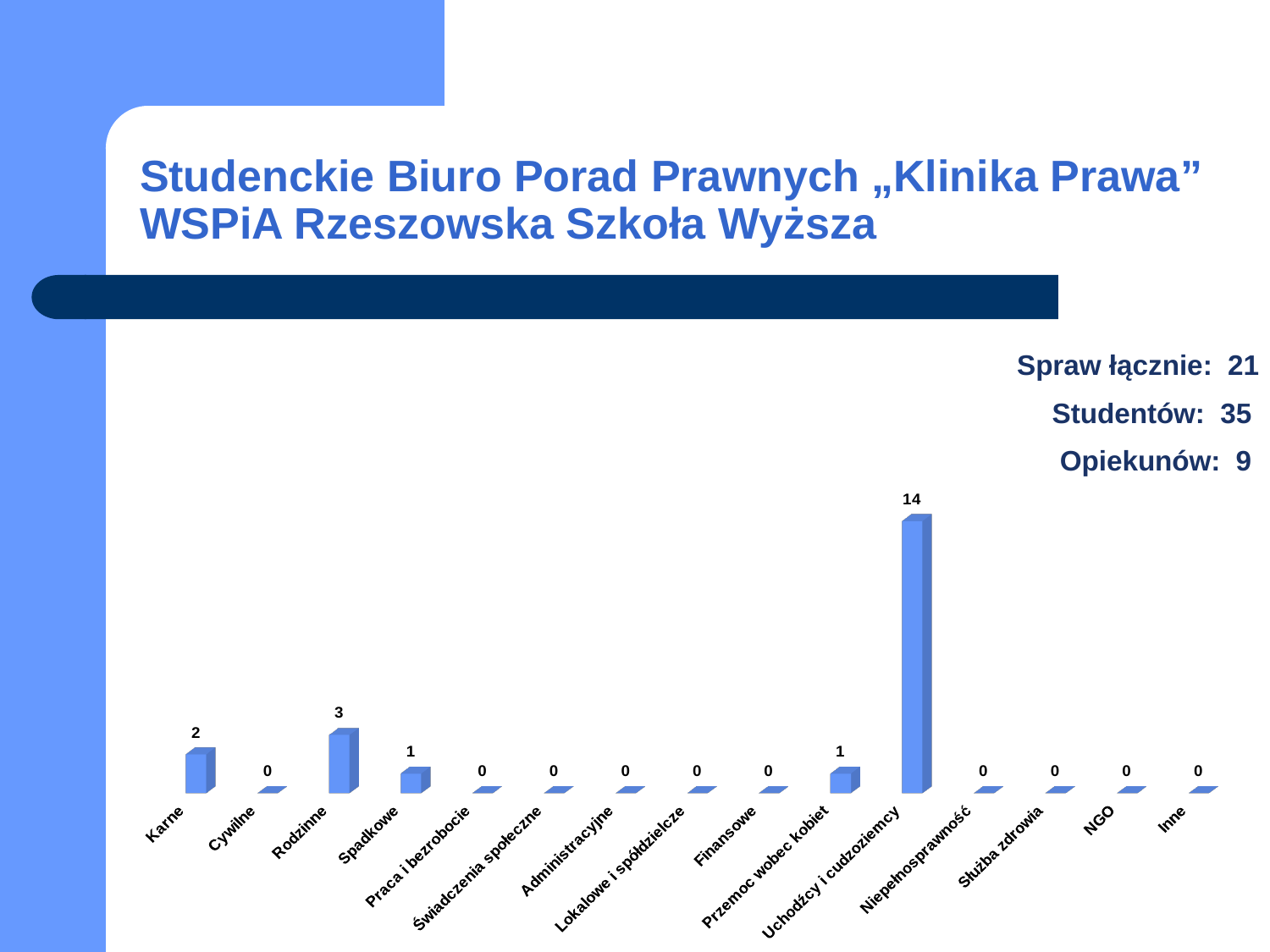
Which is larger, the value for Karne or the value for Rodzinne? Rodzinne Which category has the highest value? Uchodźcy i cudzoziemcy What kind of chart is shown on the slide? Bar chart What is the value for Uchodźcy i cudzoziemcy? 14 What is the value for Karne? 2 How many categories are shown on the x axis? 15 How many categories have a value of 0? 10 What is the difference between the values for Uchodźcy i cudzoziemcy and Rodzinne? 11 What is the value for Spadkowe? 1 What is the value for Cywilne? 0 What is the value for Przemoc wobec kobiet? 1 What is the value for Rodzinne? 3